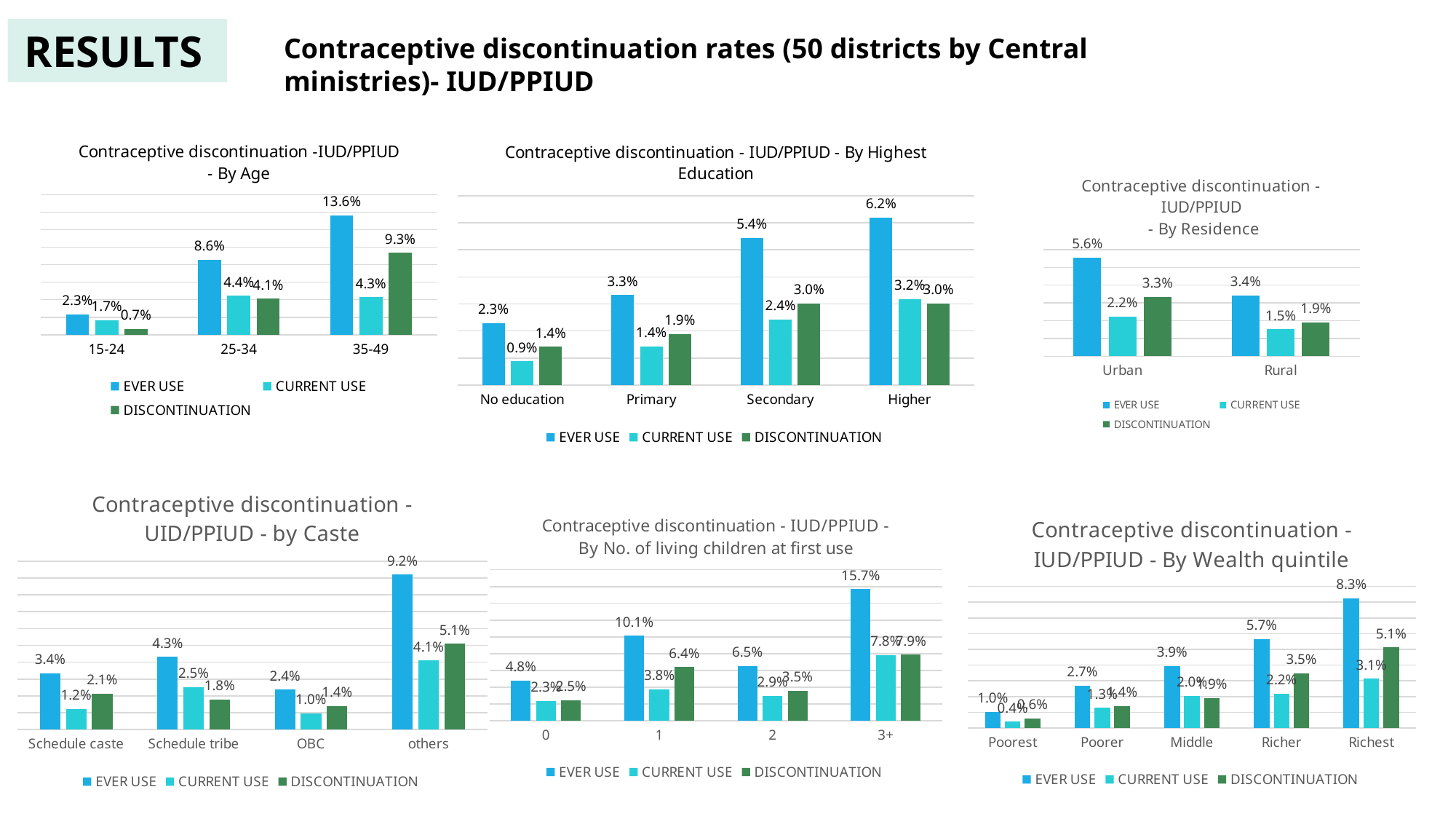
In the 'Contraceptive discontinuation - IUD/PPIUD - By No. of living children at first use' chart, what is the EVER USE value for 3+? 15.7% In the 'Contraceptive discontinuation - IUD/PPIUD - By Age' chart, what is the DISCONTINUATION value for the 35-49 age group? 9.3% In the 'Contraceptive discontinuation - IUD/PPIUD - By Highest Education' chart, what is the CURRENT USE value for Primary? 1.4% In the 'Contraceptive discontinuation - IUD/PPIUD - By Age' chart, which age group has the highest EVER USE value? 35-49 In the 'Contraceptive discontinuation - UID/PPIUD - by Caste' chart, which category has the lowest EVER USE value? OBC In the 'Contraceptive discontinuation - IUD/PPIUD - By Residence' chart, which has the larger EVER USE value, Urban or Rural? Urban In the 'Contraceptive discontinuation - UID/PPIUD - by Caste' chart, how many caste categories are shown on the x axis? 4 In the 'Contraceptive discontinuation - IUD/PPIUD - By No. of living children at first use' chart, what is the difference between the DISCONTINUATION values for 1 and 2 children? 2.9% In the 'Contraceptive discontinuation - IUD/PPIUD - By Highest Education' chart, what is the difference between the EVER USE values for Higher and No education? 3.9% In the 'Contraceptive discontinuation - IUD/PPIUD - By Residence' chart, what is the DISCONTINUATION value for Urban? 3.3% How many series does the legend list in the 'Contraceptive discontinuation - IUD/PPIUD - By Wealth quintile' chart? 3 In the 'Contraceptive discontinuation - IUD/PPIUD - By Wealth quintile' chart, does the EVER USE value rise or fall from Poorest to Richest? rise